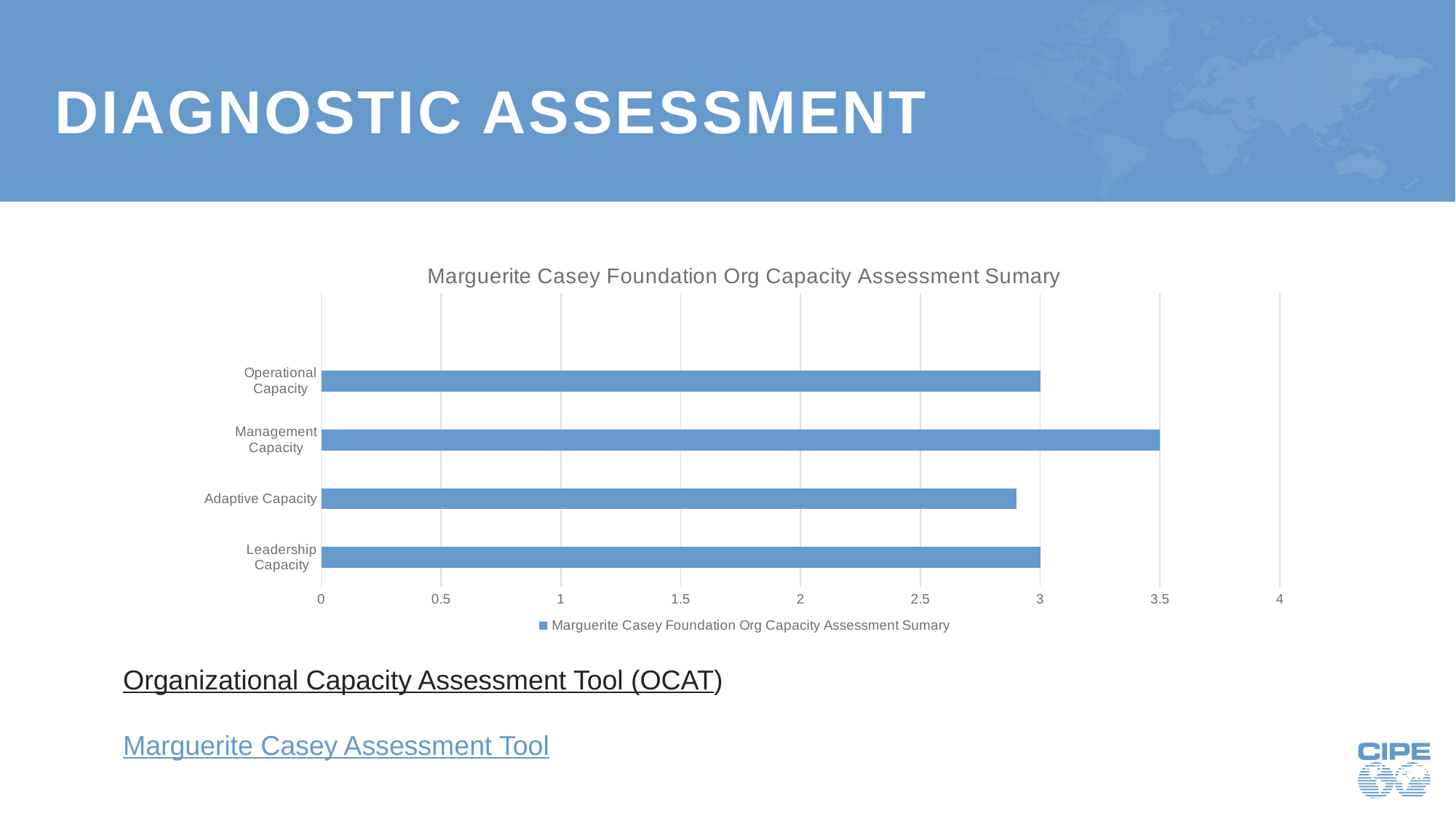
Which category has the lowest value? Adaptive Capacity How many categories are plotted in the chart? 4 What kind of chart is shown on the slide? bar chart What is the value for Leadership Capacity? 3 How many series does the legend list? 1 Is the value for Adaptive Capacity greater or less than 3? less What is the difference between the values for Management Capacity and Operational Capacity? 0.5 What is the title of the chart? Marguerite Casey Foundation Org Capacity Assessment Sumary What is the value for Operational Capacity? 3 What is the value for Management Capacity? 3.5 Which is larger, the value for Management Capacity or the value for Leadership Capacity? Management Capacity Which category has the highest value? Management Capacity